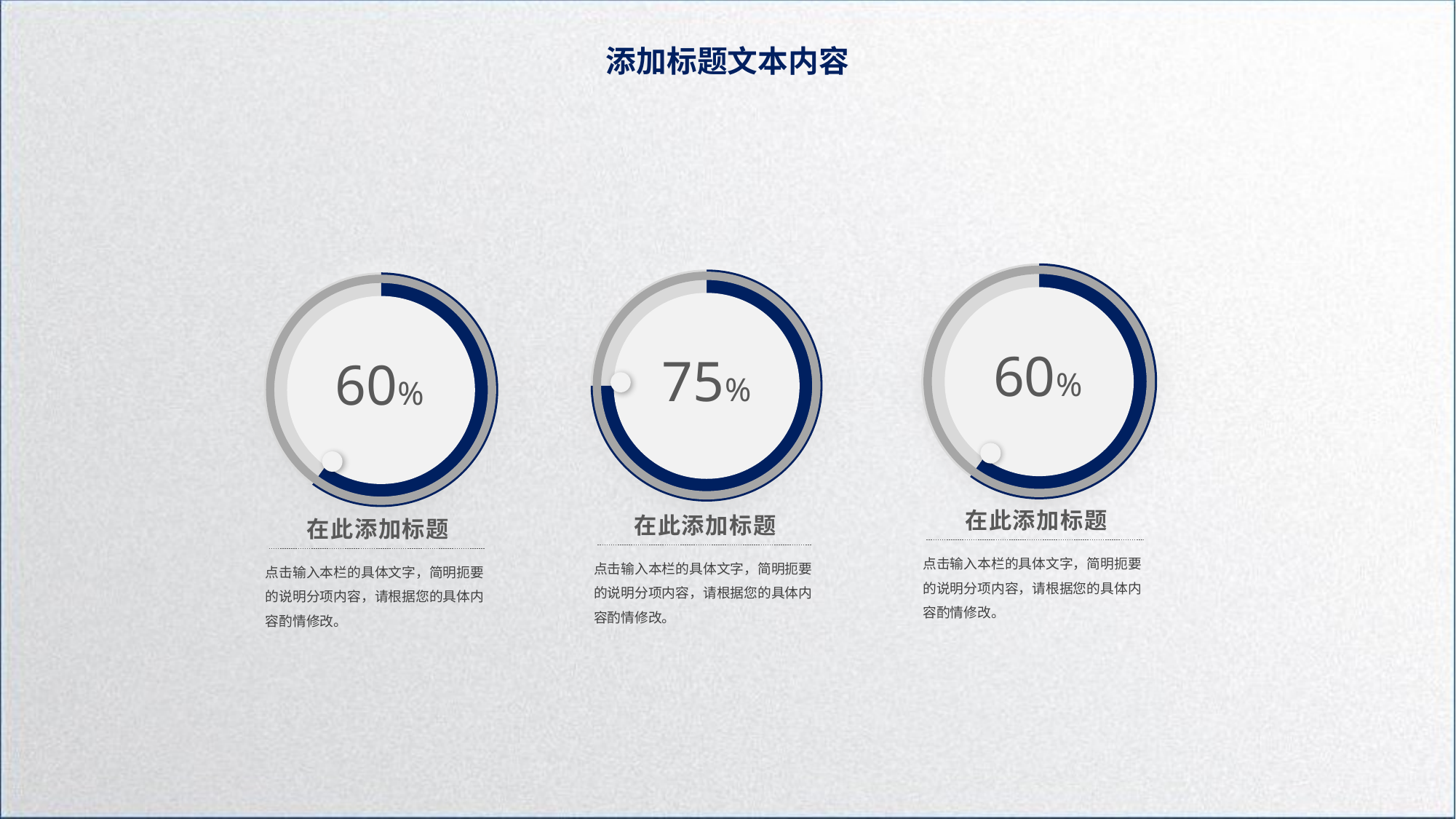
How many circular progress charts are on the slide? 3 Do the left and right circular charts show the same value? Yes What value is shown in the left circular chart? 60% What colour is the filled arc in each circular chart? Dark blue What is the difference between the value in the middle chart and the value in the left chart? 15% What kind of chart is used to display the percentages on the slide? Circular progress (doughnut) chart Which of the three circular charts shows the highest value: left, middle or right? middle What value is shown in the middle circular chart? 75% What is the title at the top of the slide? 添加标题文本内容 What value is shown in the right circular chart? 60% Is the value in the middle chart larger or smaller than the value in the right chart? larger